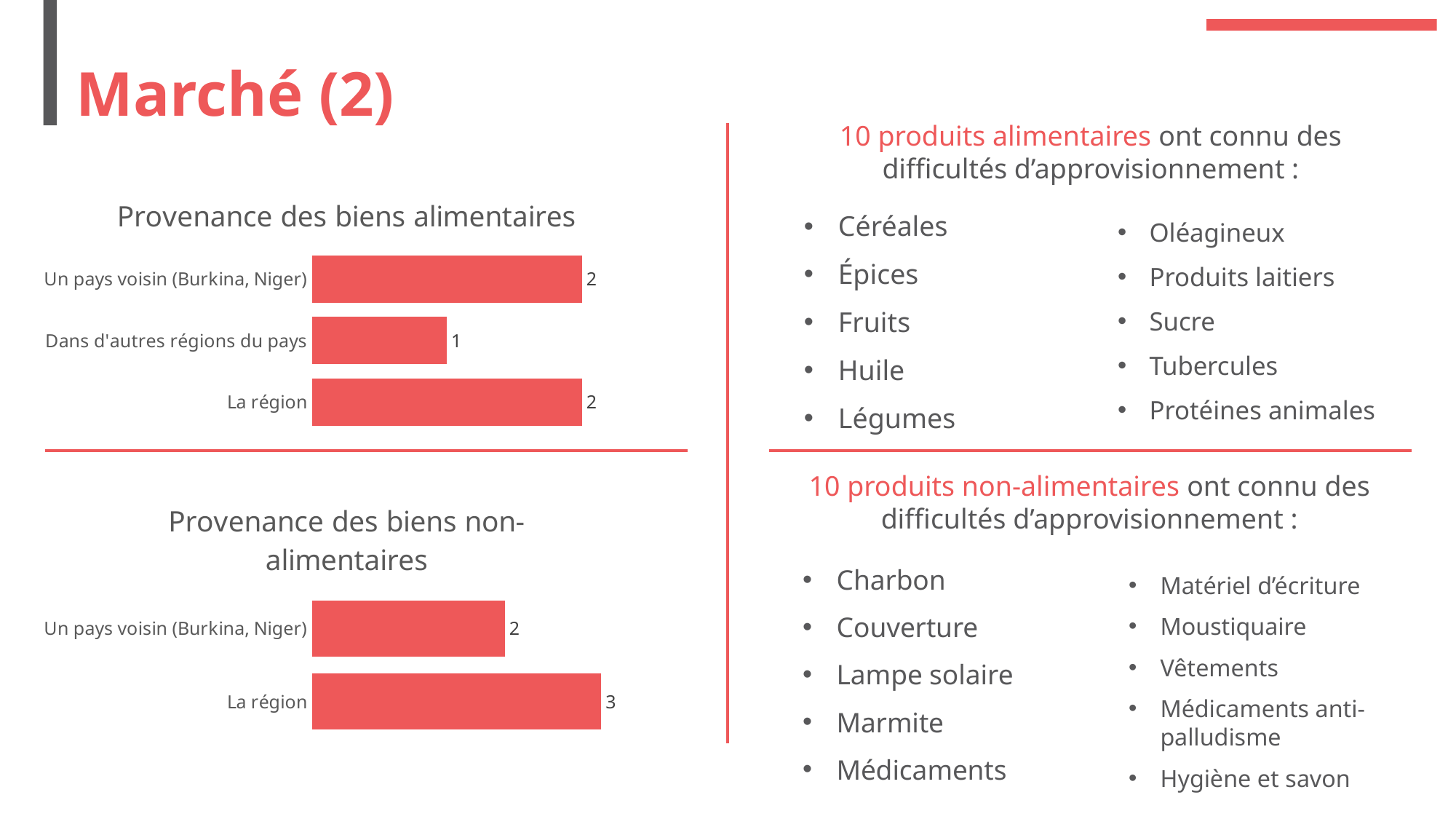
In the 'Provenance des biens alimentaires' chart, what is the difference between the values for 'La région' and 'Dans d'autres régions du pays'? 1 In the 'Provenance des biens non-alimentaires' chart, how many categories are shown? 2 In the 'Provenance des biens alimentaires' chart, what is the value for 'Un pays voisin (Burkina, Niger)'? 2 In the 'Provenance des biens non-alimentaires' chart, what is the difference between the values for 'La région' and 'Un pays voisin (Burkina, Niger)'? 1 In the 'Provenance des biens alimentaires' chart, which category has the lowest value? Dans d'autres régions du pays In the 'Provenance des biens non-alimentaires' chart, which category has the highest value? La région In the 'Provenance des biens alimentaires' chart, how many categories are shown? 3 In the 'Provenance des biens non-alimentaires' chart, what is the value for 'La région'? 3 In the 'Provenance des biens non-alimentaires' chart, which is larger: 'La région' or 'Un pays voisin (Burkina, Niger)'? La région What type of chart is the 'Provenance des biens alimentaires' chart? Bar chart In the 'Provenance des biens alimentaires' chart, what is the value for 'Dans d'autres régions du pays'? 1 In the 'Provenance des biens non-alimentaires' chart, what is the value for 'Un pays voisin (Burkina, Niger)'? 2